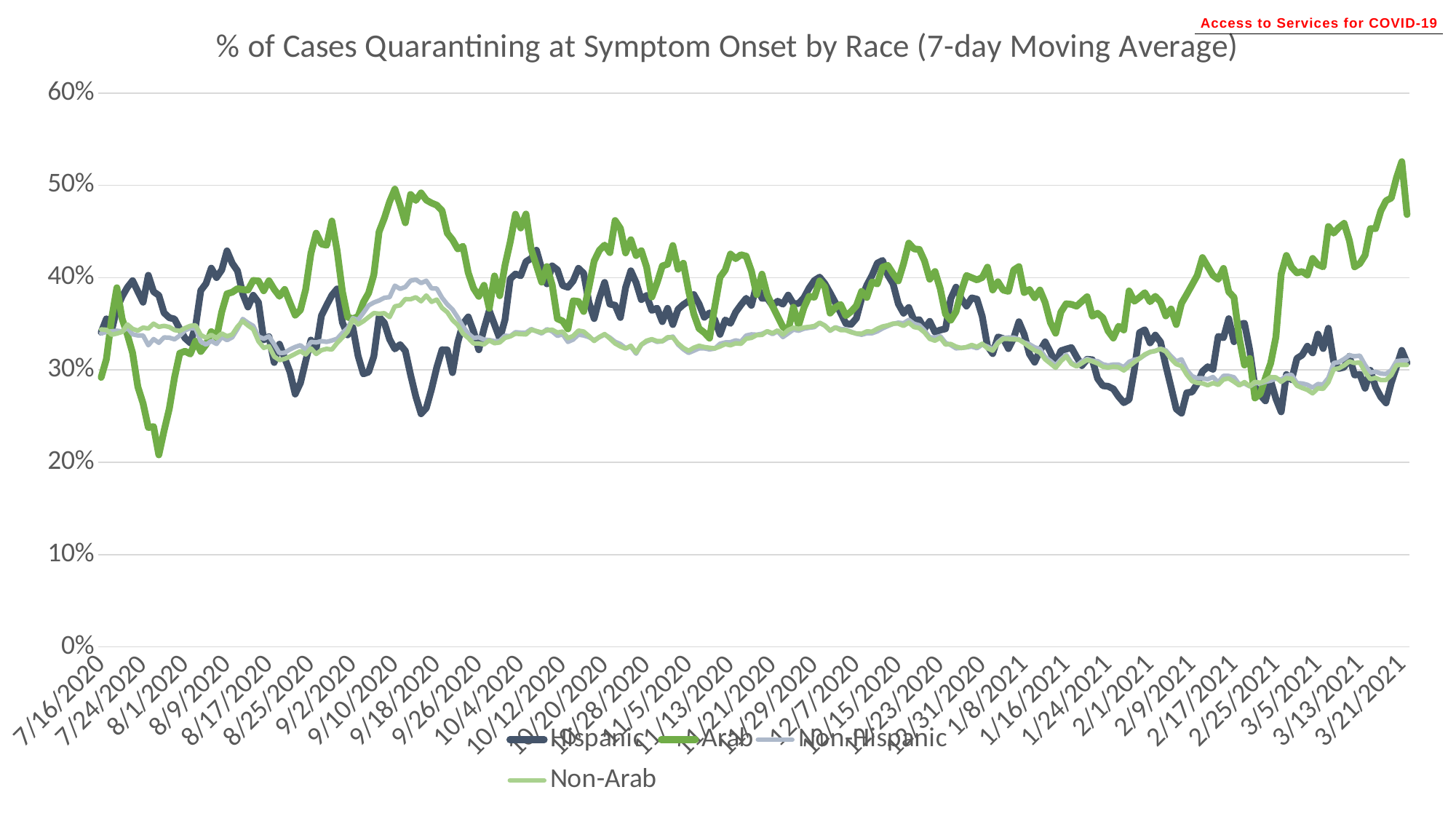
At 3/21/2021, which series has the larger value, Arab or Hispanic? Arab Which series drops to the lowest value anywhere on the chart? Arab Is the lowest value for Arab around 8/1/2020 greater or less than 30%? less Is the value for Non-Arab around 12/15/2020 greater or less than 40%? less What is the highest value shown on the vertical axis? 60% How many series does the legend list? 4 What is the title of the chart? % of Cases Quarantining at Symptom Onset by Race (7-day Moving Average) What kind of chart is shown on the slide? line chart Is the value for Arab around 9/18/2020 greater or less than 40%? greater Does the Arab series rise or fall between 2/25/2021 and 3/21/2021? rise Which series reaches the highest value anywhere on the chart? Arab